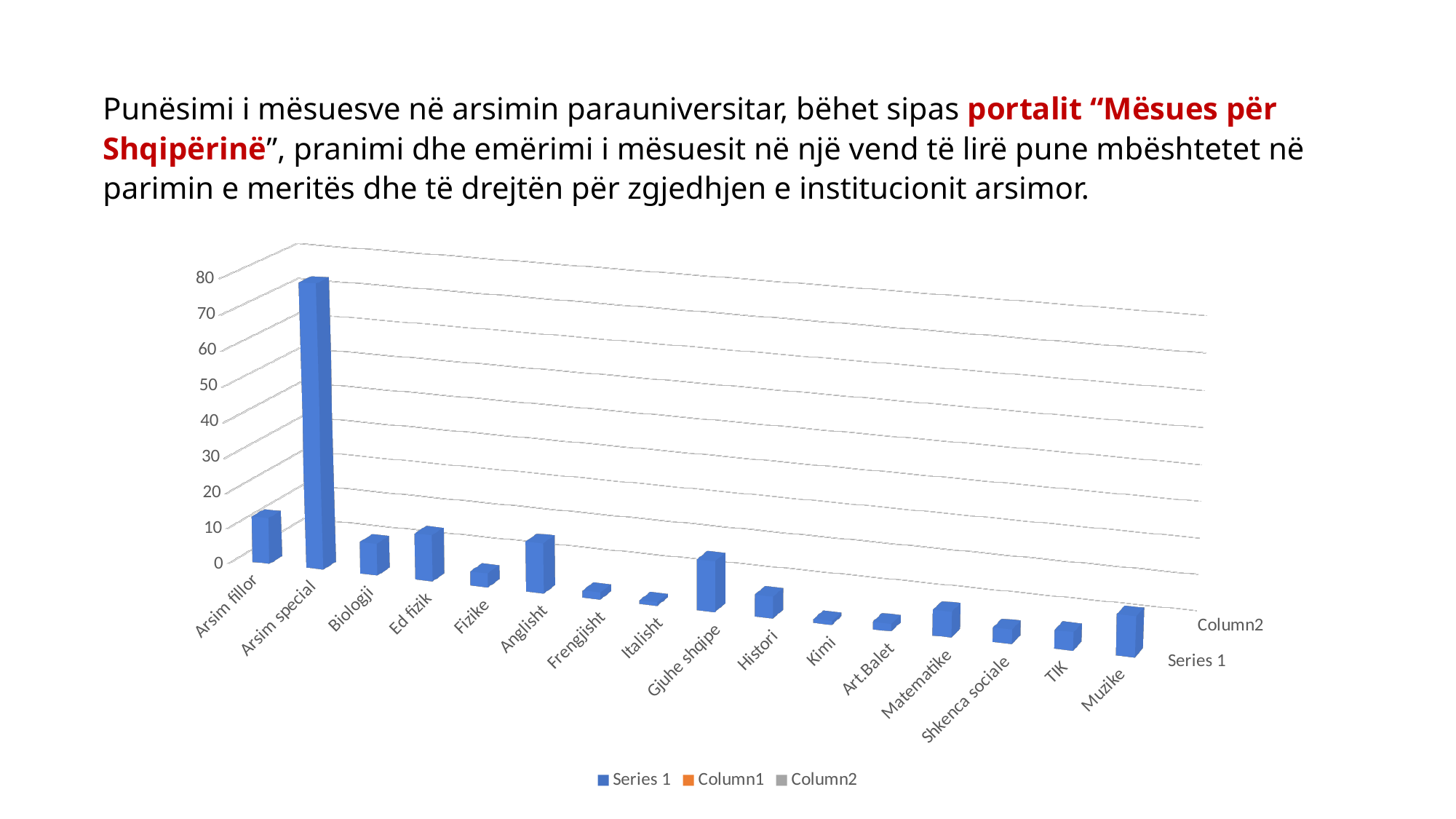
Is the value for Arsim special greater or less than 70? greater Is the value for Anglisht greater or less than 20? less Which is larger, the value for Arsim special or the value for Arsim fillor? Arsim special Is the value for Gjuhe shqipe greater or less than 30? less What kind of chart is shown on the slide? bar chart Which category has the highest value in the chart? Arsim special What is the highest value shown on the vertical axis of the chart? 80 Which is larger, the value for Arsim fillor or the value for Fizike? Arsim fillor What is the first entry listed in the chart legend? Series 1 How many series does the chart legend list? 3 How many categories are shown on the x axis of the chart? 16